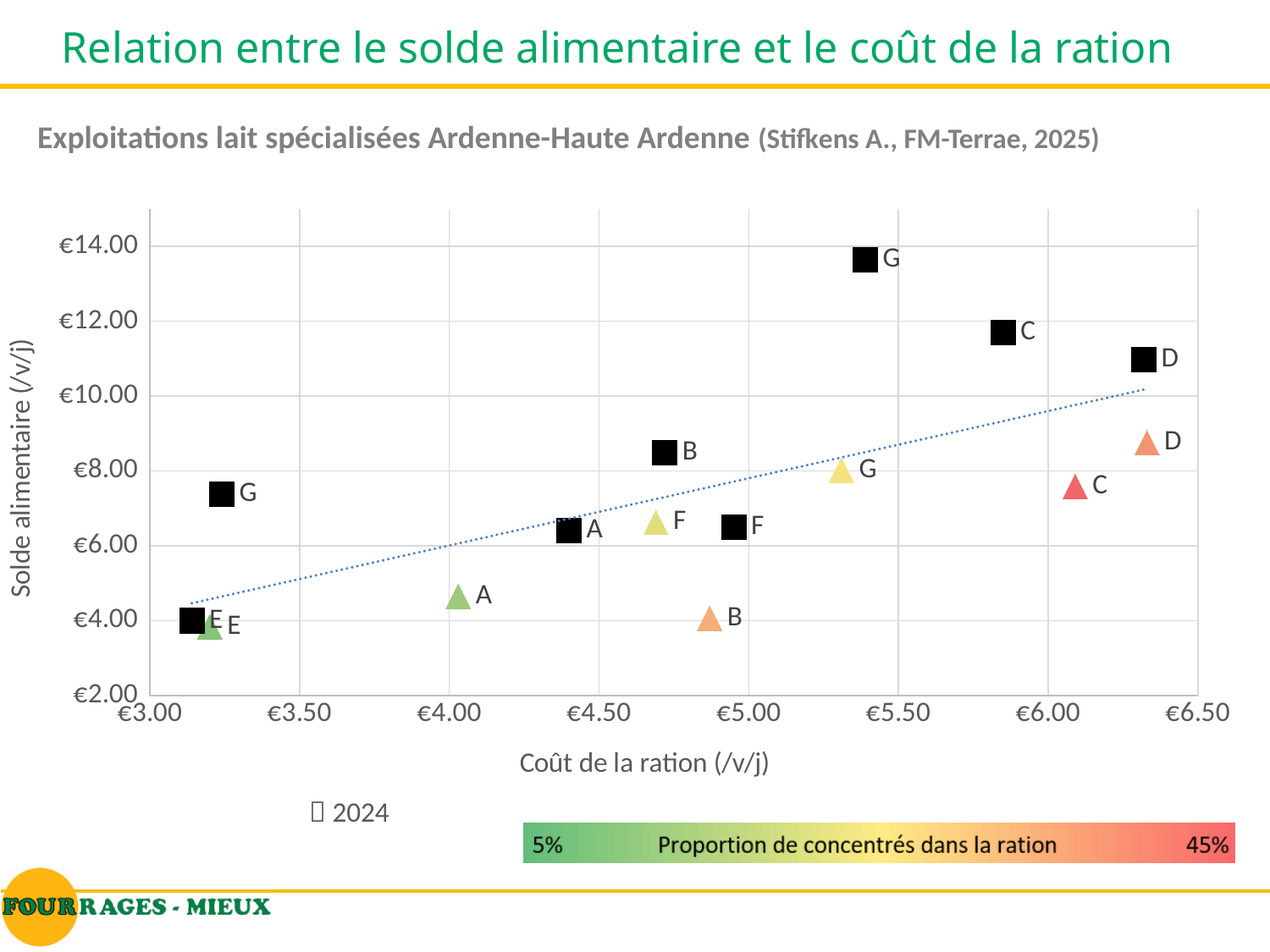
Which has the higher 'Solde alimentaire' value, the triangle labelled G or the triangle labelled F? G What range of 'Proportion de concentrés dans la ration' does the colour scale below the chart cover? 5% to 45% Is the 'Solde alimentaire' value for the black square labelled E greater or less than €6.00? less Which has the higher 'Solde alimentaire' value, the black square labelled C or the black square labelled D? C Is the 'Coût de la ration' value for the triangle labelled C greater or less than €6.00? greater Is the 'Solde alimentaire' value for the triangle labelled B greater or less than €6.00? less What kind of chart is shown on the slide? scatter chart Which point has the highest 'Solde alimentaire' value on the chart? G (black square) How many triangle markers are plotted on the chart? 7 Does the dotted trend line rise or fall as 'Coût de la ration' increases? rises